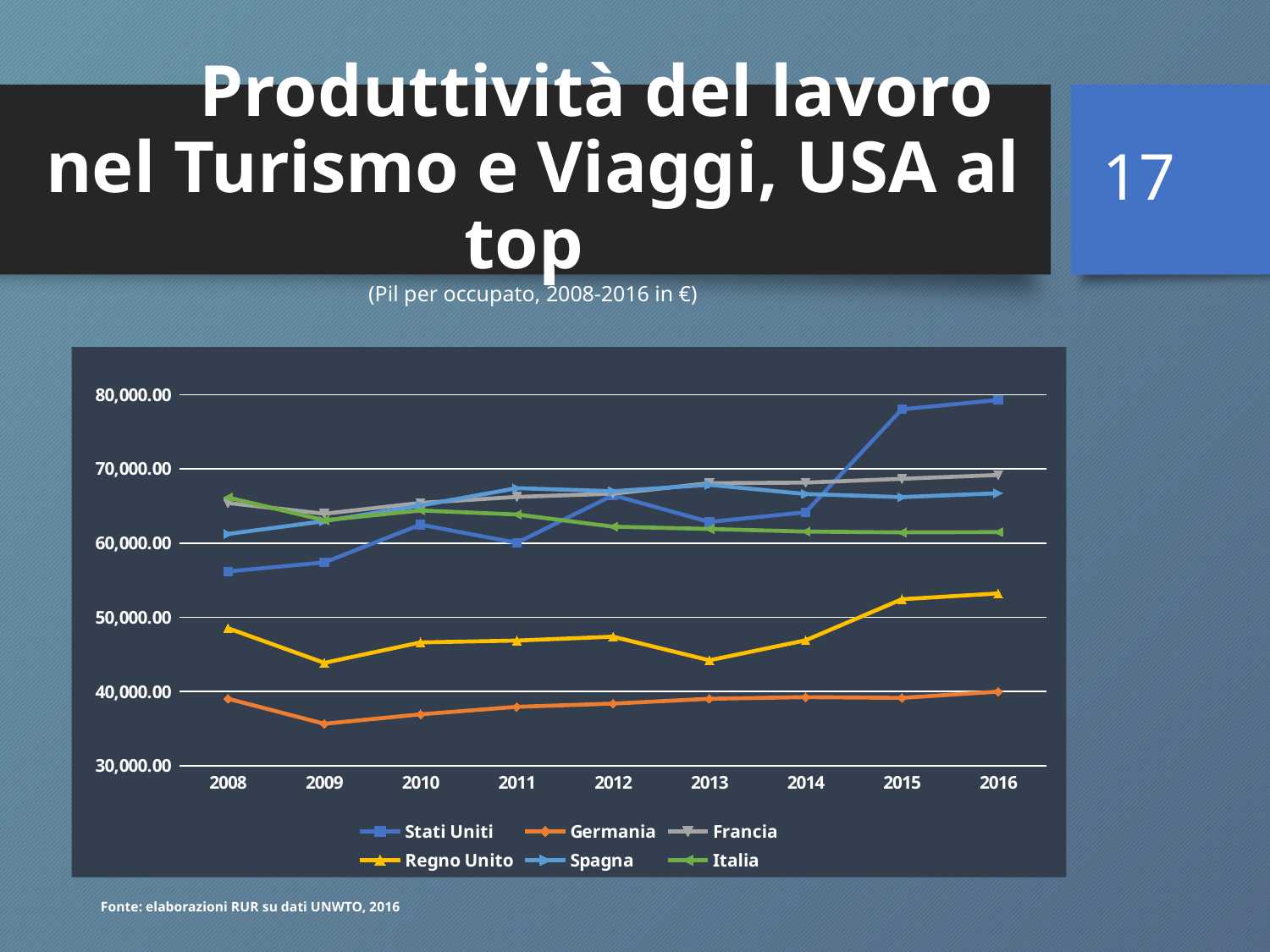
Is the value for Stati Uniti in 2015 greater or less than 70,000.00? greater How many series does the legend list? 6 Which country has the lowest value in 2016? Germania Which country has the highest value in 2016? Stati Uniti Which country has the lowest value in 2008? Germania What is the source cited below the chart? Fonte: elaborazioni RUR su dati UNWTO, 2016 What kind of chart is shown on the slide? line chart Which is larger in 2016, the value for Regno Unito or the value for Germania? Regno Unito Is the value for Germania in 2009 greater or less than 40,000.00? less How many years are plotted along the x axis? 9 Is the value for Regno Unito in 2016 greater or less than 50,000.00? greater Does the value for Italia rise or fall from 2008 to 2016? fall